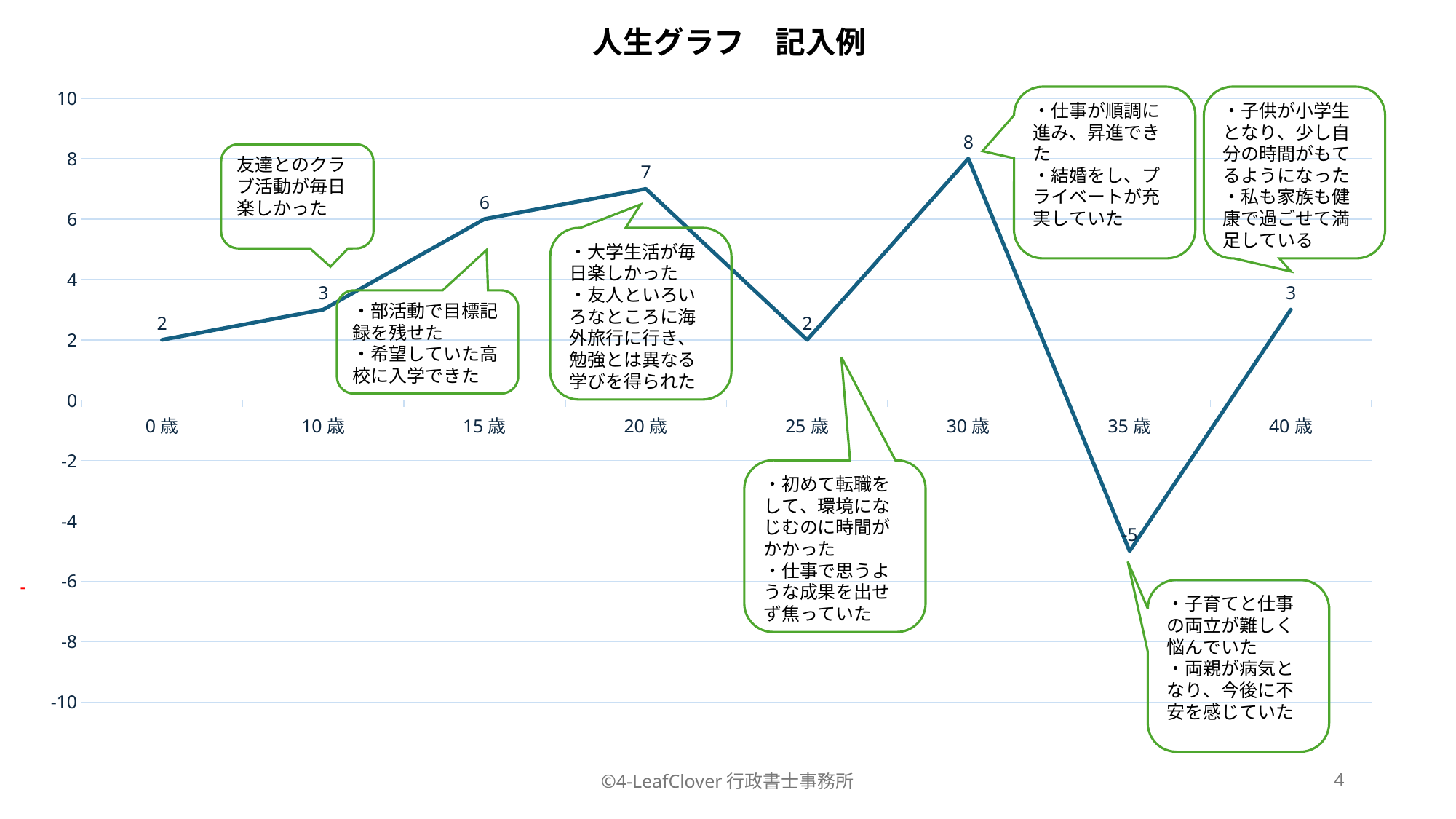
What is the value at 20歳? 7 Which has the larger value, 15歳 or 25歳? 15歳 What is the value at 30歳? 8 At which age is the value highest? 30歳 What is the value at 15歳? 6 Is the value at 35歳 greater or less than 0? less At which age is the value lowest? 35歳 What kind of chart is shown on the slide? line chart What is the value at 0歳? 2 What is the difference between the values at 30歳 and 25歳? 6 How many age points are plotted on the x axis? 8 Does the line rise or fall from 20歳 to 25歳? fall